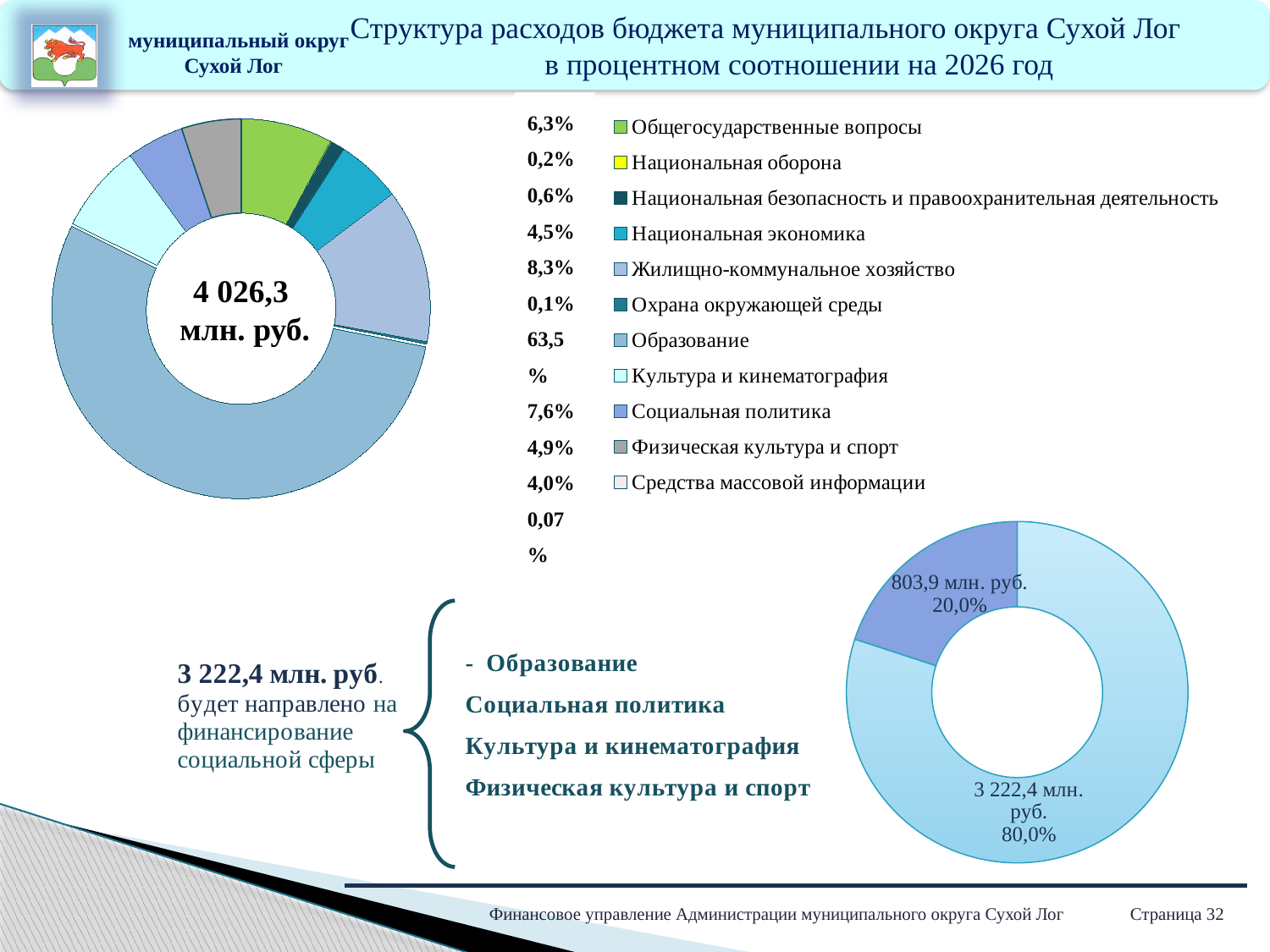
In the large chart on the left, which is larger: Жилищно-коммунальное хозяйство or Национальная экономика? Жилищно-коммунальное хозяйство In the small doughnut chart at the bottom right, what amount corresponds to the 80,0% slice? 3 222,4 млн. руб. In the large chart on the left, what percentage is shown for Национальная экономика? 4,5% In the large chart on the left, what percentage is shown for Жилищно-коммунальное хозяйство? 8,3% In the large chart on the left, what is the difference between the shares of Жилищно-коммунальное хозяйство and Общегосударственные вопросы? 2,0% In the large chart on the left, what percentage is shown for Общегосударственные вопросы? 6,3% In the large chart on the left, what percentage is shown for Охрана окружающей среды? 0,1% In the large chart on the left, how many categories does the legend list? 11 In the large chart on the left, what total amount is printed in the centre of the doughnut? 4 026,3 млн. руб. In the small doughnut chart at the bottom right, what share of the total does the 803,9 млн. руб. slice represent? 20,0% In the large chart on the left, which category has the largest share of expenditure? Образование What kind of chart is the large chart on the left of the slide? doughnut chart